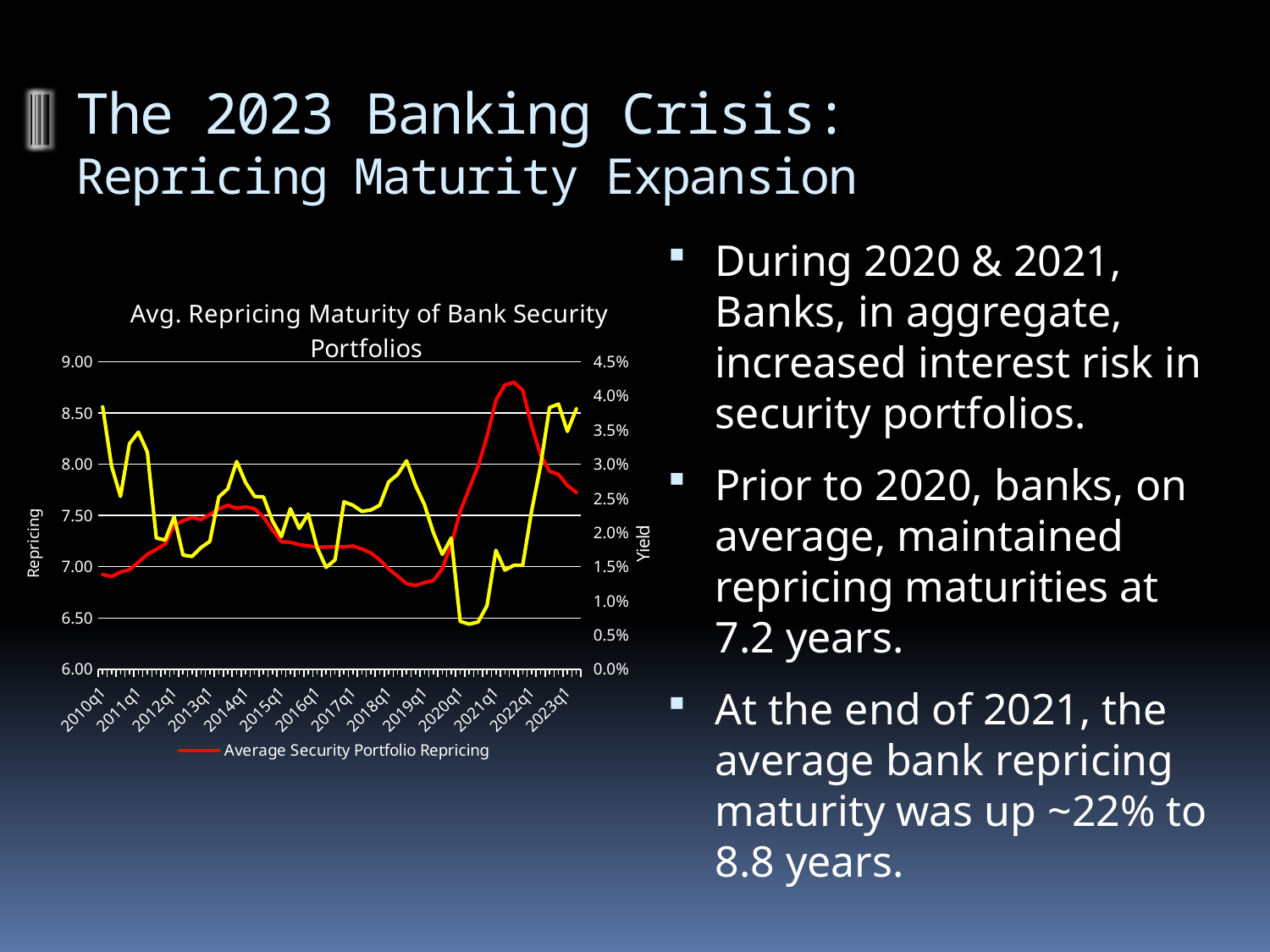
How many series does the chart's legend list? 1 What series name is shown in the chart's legend? Average Security Portfolio Repricing What is the title of the chart? Avg. Repricing Maturity of Bank Security Portfolios Is the Average Security Portfolio Repricing value at 2020q1 greater or less than 7.00? greater Which is larger for the Average Security Portfolio Repricing line: the value at 2022q1 or the value at 2010q1? 2022q1 Is the yellow yield line at 2010q1 greater or less than 3.0%? greater What kind of chart is shown on the slide? line chart Is the yellow yield line's lowest point, around late 2020, greater or less than 1.0%? less Does the Average Security Portfolio Repricing line rise or fall between 2019q1 and 2022q1? rise